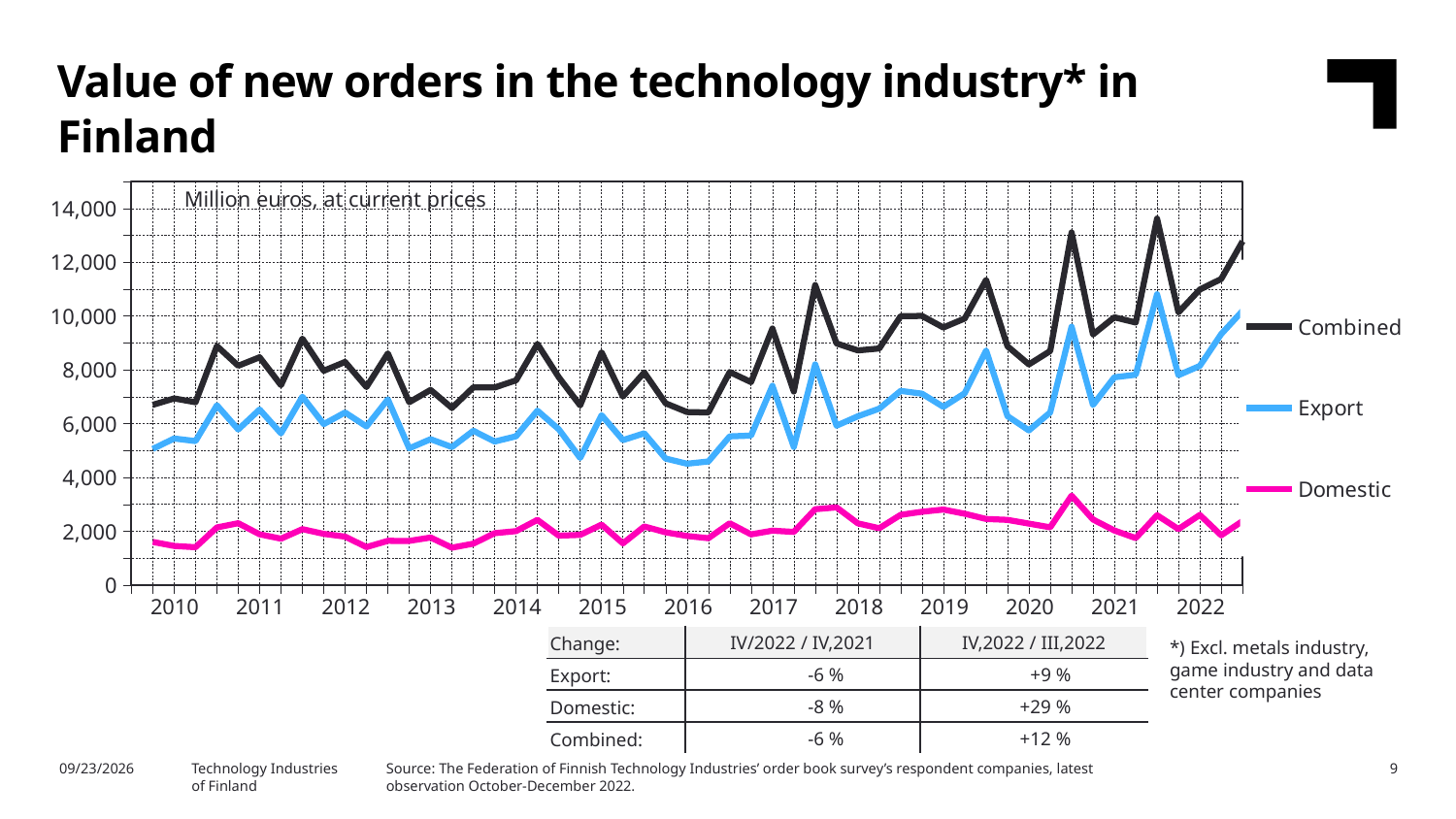
Which series has the lowest values throughout the chart? Domestic What unit is stated inside the chart area? Million euros, at current prices How many series does the chart's legend list? 3 What are the three series named in the chart's legend? Combined, Export, Domestic What kind of chart is shown on the slide? line chart Is the Domestic series ever greater or less than 4,000 over the whole period? less Is the peak value of the Combined series in 2021 greater or less than 12,000? greater Is the Export value at the end of 2022 greater or less than 8,000? greater Which series has the highest values throughout the chart? Combined Overall, does the Combined series rise or fall from 2010 to 2022? rise Which series is larger in 2022, Export or Domestic? Export